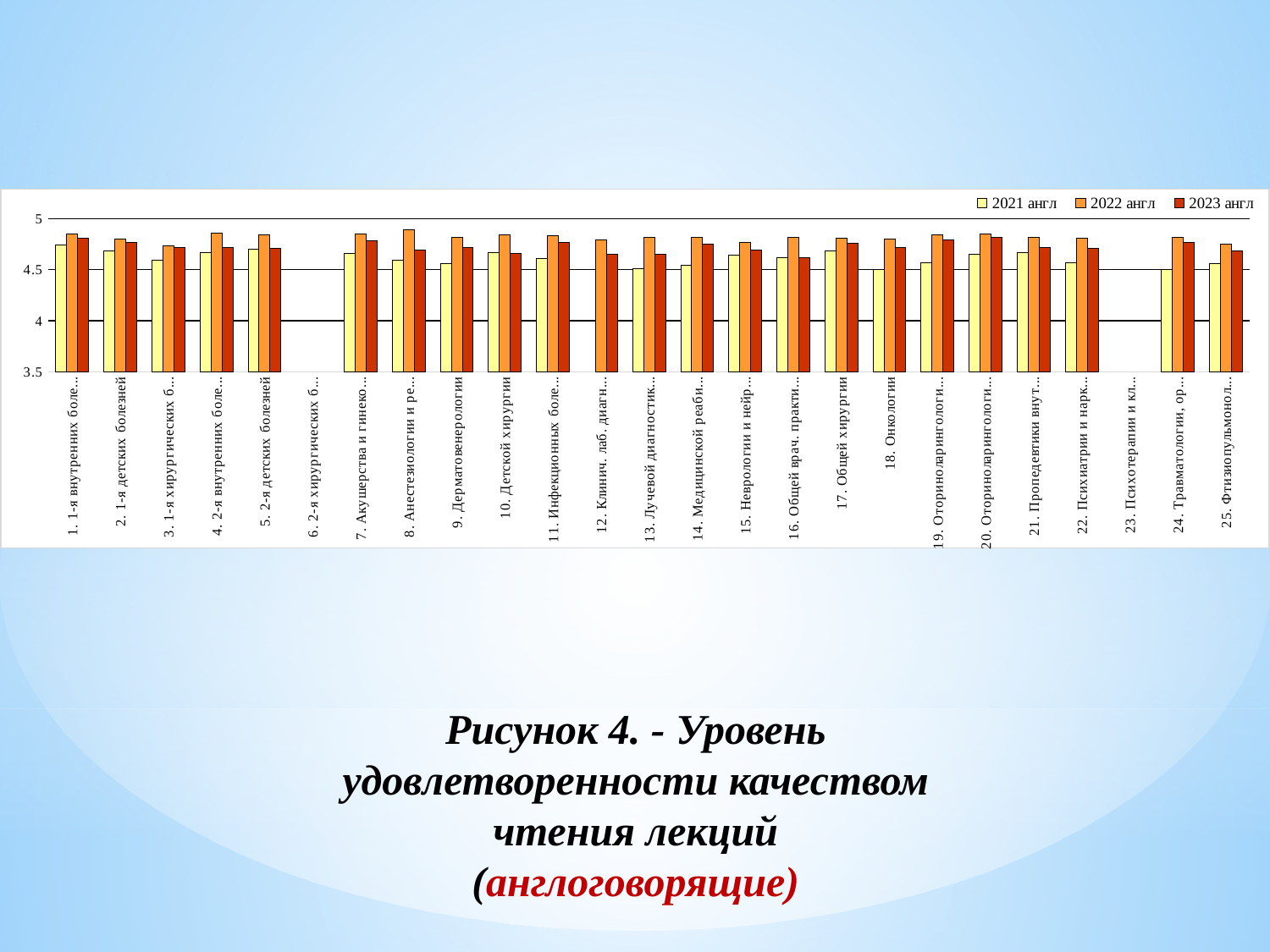
How many series does the legend list? 3 For 9. Дерматовенерологии, which series has the larger value, 2021 англ or 2023 англ? 2023 англ Which two categories have no bars plotted? 6. 2-я хирургических б... and 23. Психотерапии и кл... For 18. Онкологии, which series has the larger value, 2021 англ or 2022 англ? 2022 англ What kind of chart is shown on the slide? bar chart Is the value for 2021 англ for 10. Детской хирургии greater or less than 4.5? greater For 8. Анестезиологии и ре..., which series has the larger value, 2021 англ or 2022 англ? 2022 англ How many categories are shown along the x axis? 25 Is the value for 2022 англ for 9. Дерматовенерологии greater or less than 4.5? greater What are the series names listed in the legend? 2021 англ, 2022 англ, 2023 англ Is the value for 2021 англ for 1. 1-я внутренних боле... greater or less than 4.5? greater